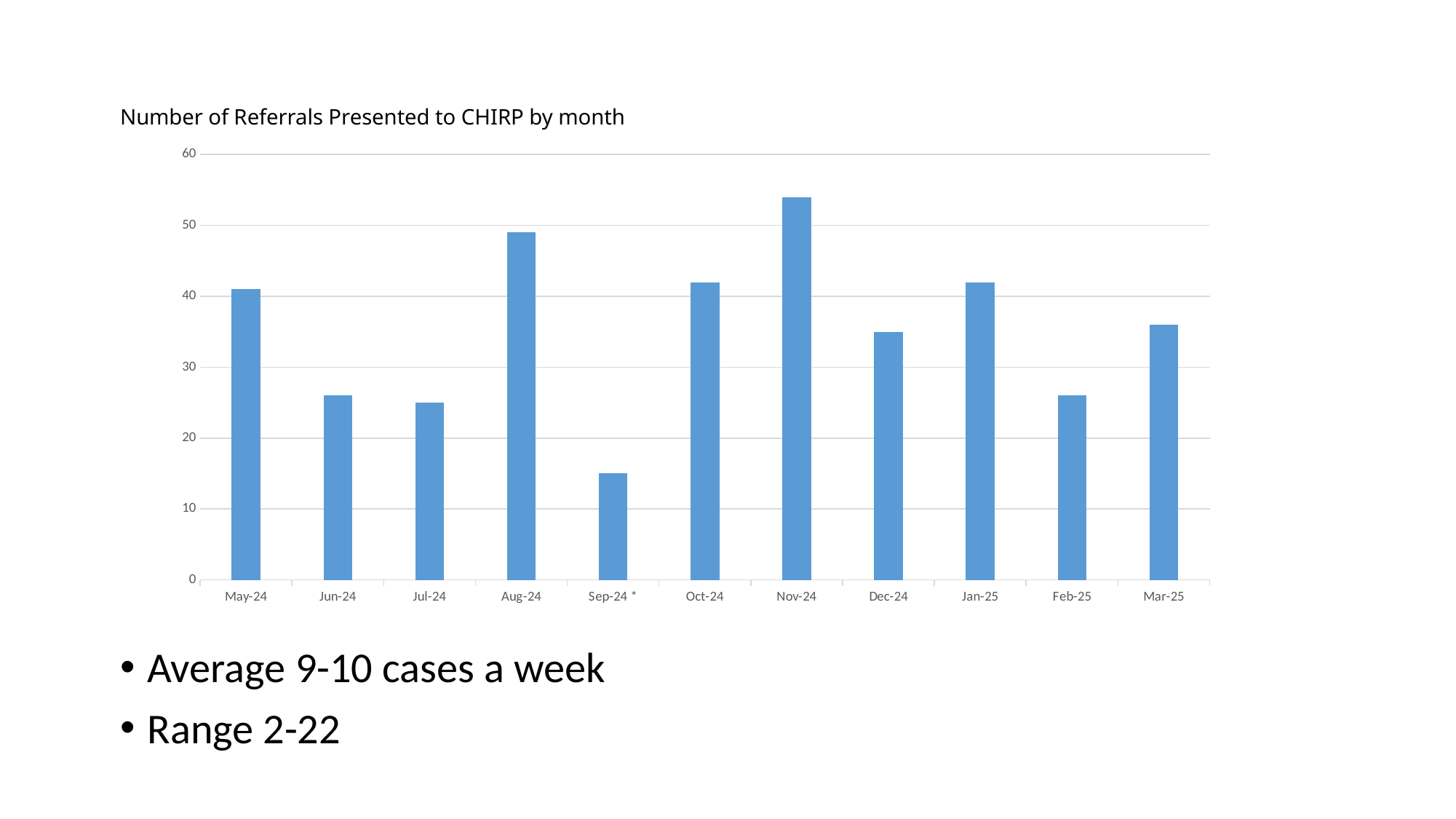
Which month has the lowest number of referrals? Sep-24 * What is the title of the chart? Number of Referrals Presented to CHIRP by month What kind of chart is shown on the slide? Bar chart Do the values rise or fall from Jun-24 to Aug-24? Rise Which month has the highest number of referrals? Nov-24 Is the value for Sep-24 * greater or less than 20? less Which month has more referrals, Aug-24 or Oct-24? Aug-24 Which month has more referrals, Jul-24 or Sep-24 *? Jul-24 Is the value for Mar-25 greater or less than 40? less Is the value for Nov-24 greater or less than 50? greater How many months are shown on the x axis of the chart? 11